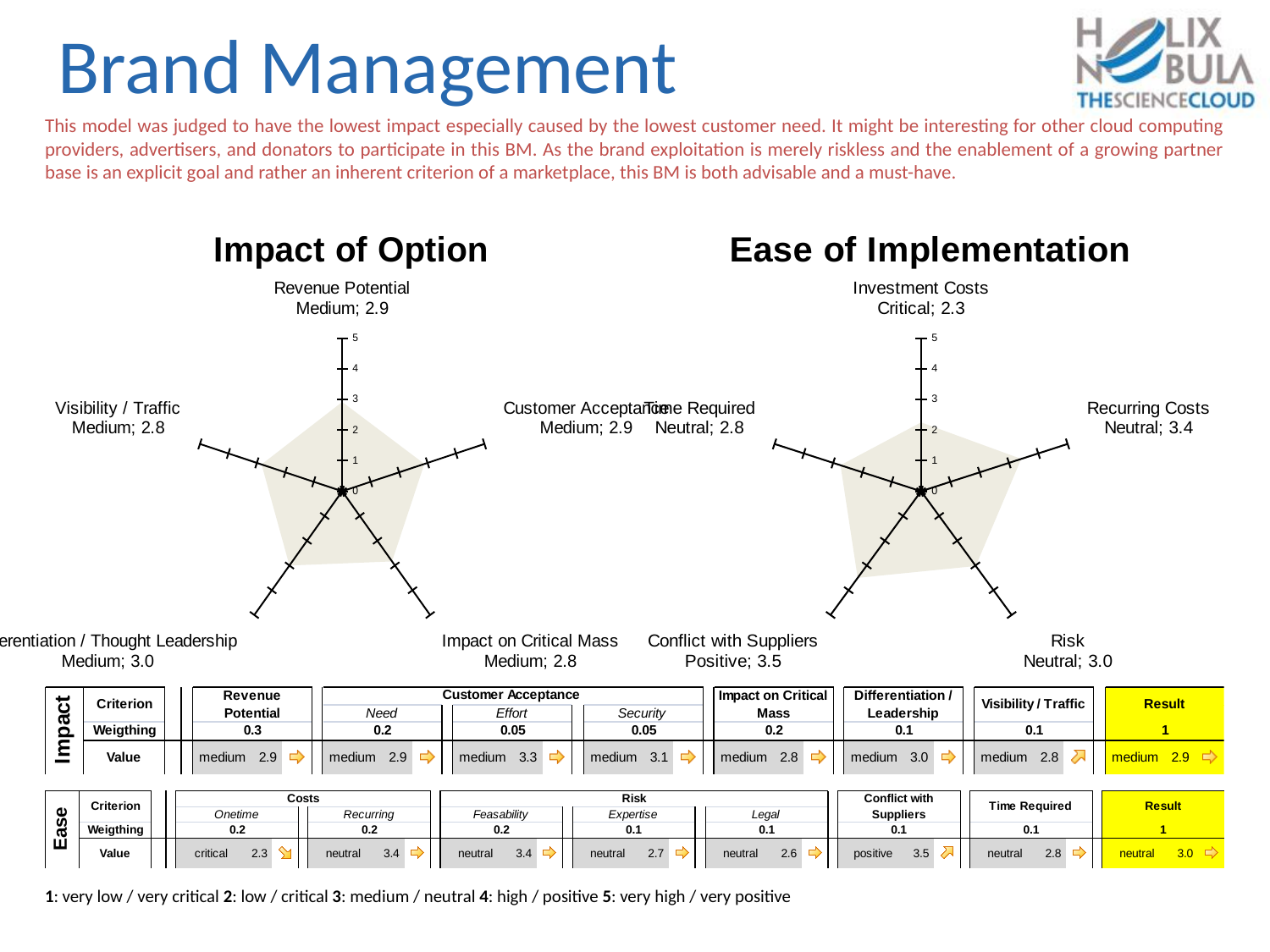
On the Impact of Option chart, what is the value for Impact on Critical Mass? 2.8 What kind of chart is the Ease of Implementation chart? radar chart On the Ease of Implementation chart, what rating label is shown for Recurring Costs? Neutral On the Ease of Implementation chart, which is larger: the value for Risk or the value for Investment Costs? Risk On the Ease of Implementation chart, which criterion has the lowest value? Investment Costs On the Ease of Implementation chart, what is the value for Investment Costs? 2.3 On the Ease of Implementation chart, what is the value for Conflict with Suppliers? 3.5 How many criteria (axes) does the Impact of Option chart have? 5 On the Ease of Implementation chart, is the value for Investment Costs greater or less than 3? less On the Impact of Option chart, what is the value for Revenue Potential? 2.9 On the Ease of Implementation chart, what is the difference between the values for Recurring Costs and Investment Costs? 1.1 What is the maximum value shown on the axis scale of the Impact of Option chart? 5